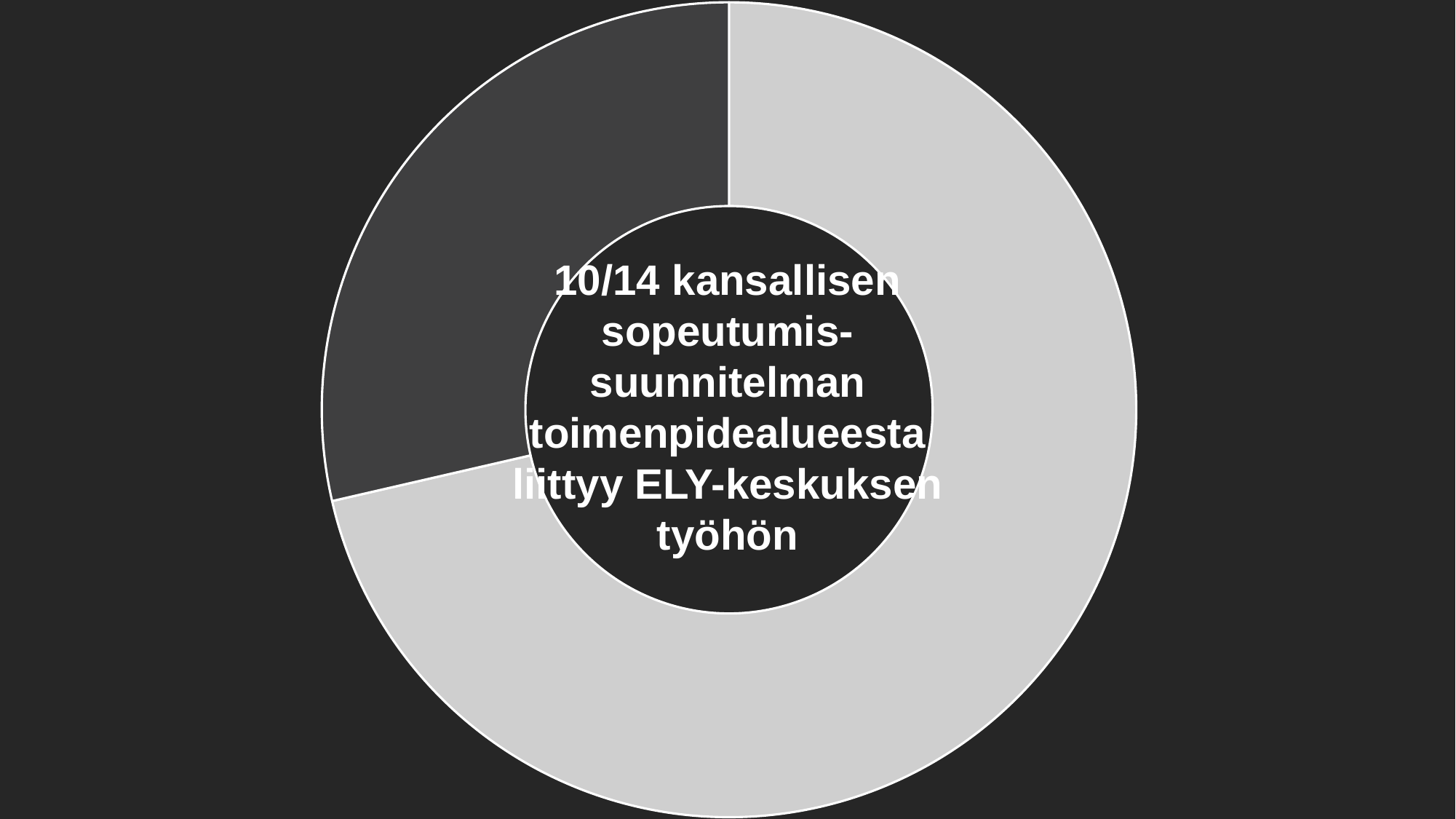
Which slice of the doughnut chart is larger, the light grey one or the dark grey one? The light grey one Which slice of the doughnut chart is the smallest? The dark grey slice What kind of chart is shown on the slide? Doughnut chart According to the text in the centre of the chart, how many of the 14 action areas of the national adaptation plan relate to the ELY centre's work? 10/14 Does the light grey slice cover more or less than half of the doughnut chart? More How many slices does the doughnut chart have? 2